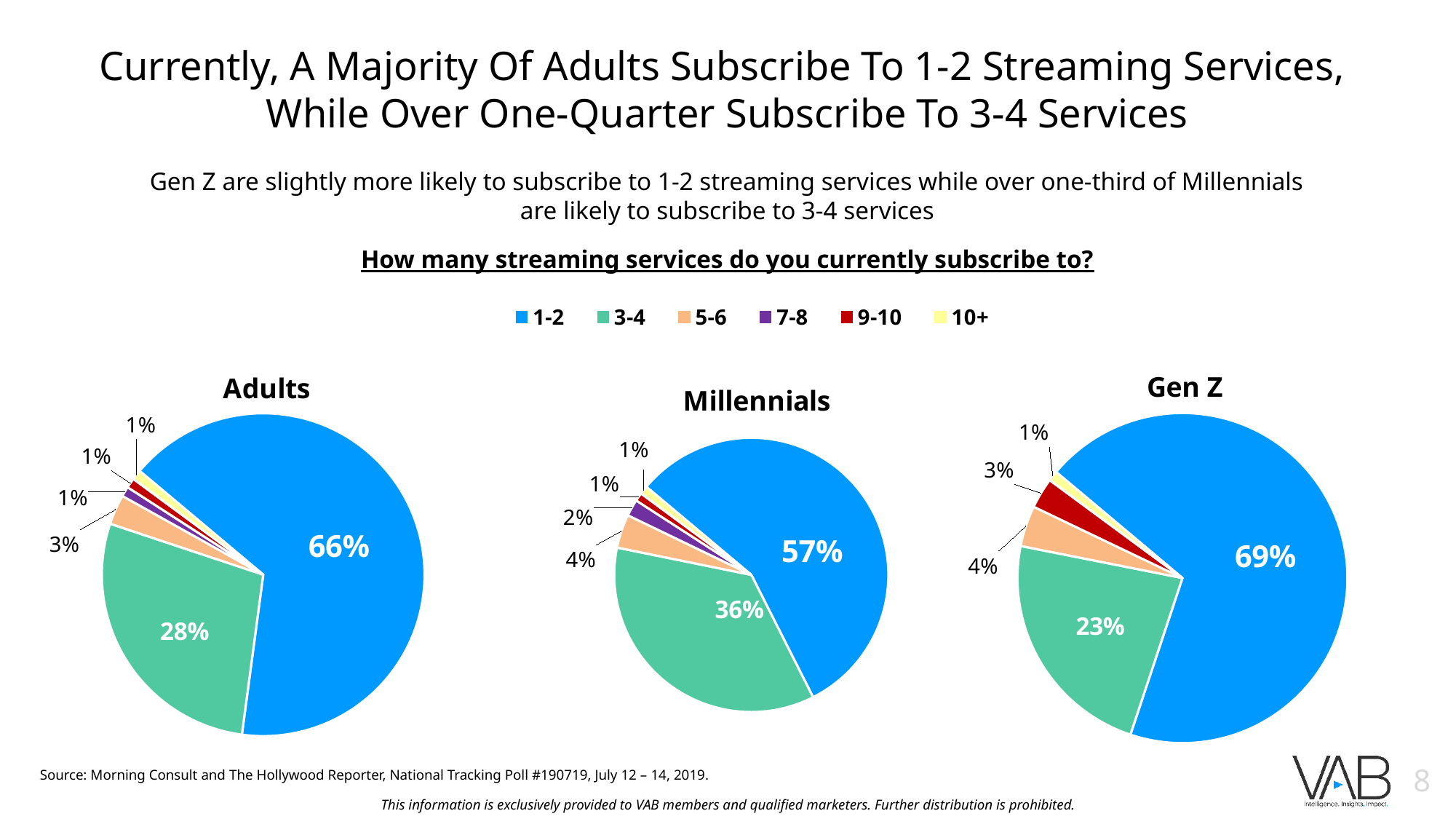
How many series does the legend list? 6 In the Adults pie chart, what share of adults subscribe to 1-2 streaming services? 66% In the Millennials pie chart, what share subscribe to 3-4 streaming services? 36% In the Millennials pie chart, what is the difference between the 1-2 share and the 3-4 share? 21% How many pie charts are on the slide? 3 In the Adults pie chart, which category has the largest share? 1-2 In the Gen Z pie chart, what share subscribe to 1-2 streaming services? 69% In the Adults pie chart, what is the difference between the 1-2 share and the 3-4 share? 38% What kind of charts are shown on the slide? Pie charts Which group has the larger share for 3-4 streaming services, Millennials or Gen Z? Millennials In the Gen Z pie chart, what share subscribe to 3-4 streaming services? 23% In the Millennials pie chart, what share subscribe to 5-6 streaming services? 4%